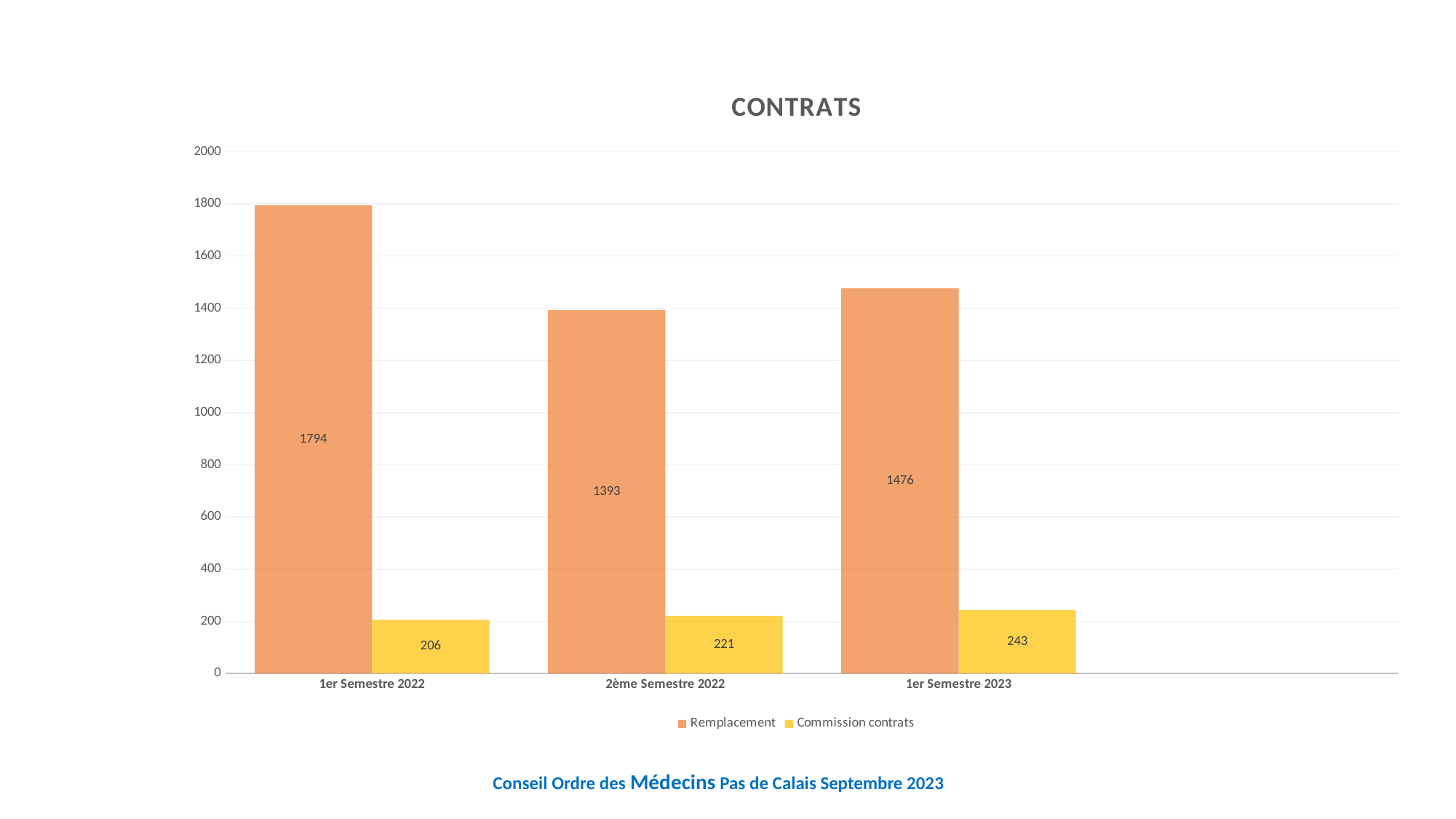
What is the value of Remplacement for 1er Semestre 2022? 1794 What is the value of Remplacement for 1er Semestre 2023? 1476 Is the Remplacement value for 2ème Semestre 2022 greater or less than 1400? less Which period has the lowest Commission contrats value? 1er Semestre 2022 Which is larger: Commission contrats for 1er Semestre 2023 or for 2ème Semestre 2022? 1er Semestre 2023 Which period has the highest Remplacement value? 1er Semestre 2022 What is the difference between the Remplacement values for 1er Semestre 2022 and 2ème Semestre 2022? 401 What is the value of Commission contrats for 2ème Semestre 2022? 221 How many series does the legend list? 2 What is the title of the chart? CONTRATS How many periods are shown on the x axis? 3 What kind of chart is shown? bar chart